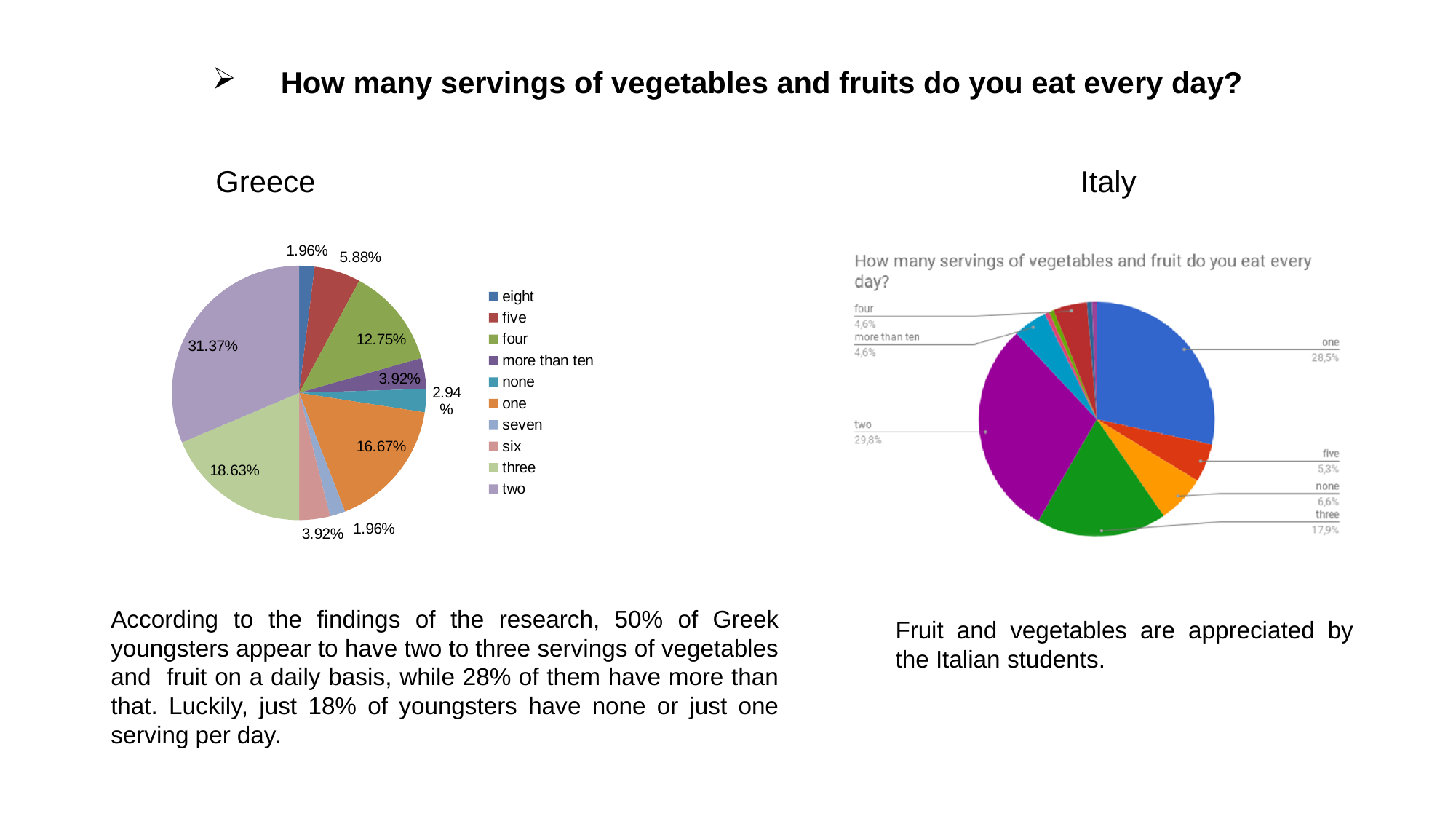
In the Greece chart, what share of respondents eat two servings? 31.37% In the Greece chart, what is the value for three servings? 18.63% In the Italy chart, what is the value for three servings? 17,9% In the Greece chart, which category has the largest slice? two In the Greece chart, what is the difference between the shares for two and three servings? 12.74% In the Italy chart, what is the difference between the shares for two and one servings? 1,3% In the Greece chart, which is larger: the share for four servings or the share for five servings? four In the Italy chart, which category has the largest slice? two What type of chart is used for Greece? pie chart In the Greece chart, what is the value for one serving? 16.67% In the Italy chart, what is the value for one serving? 28,5% How many categories does the legend of the Greece chart list? 10